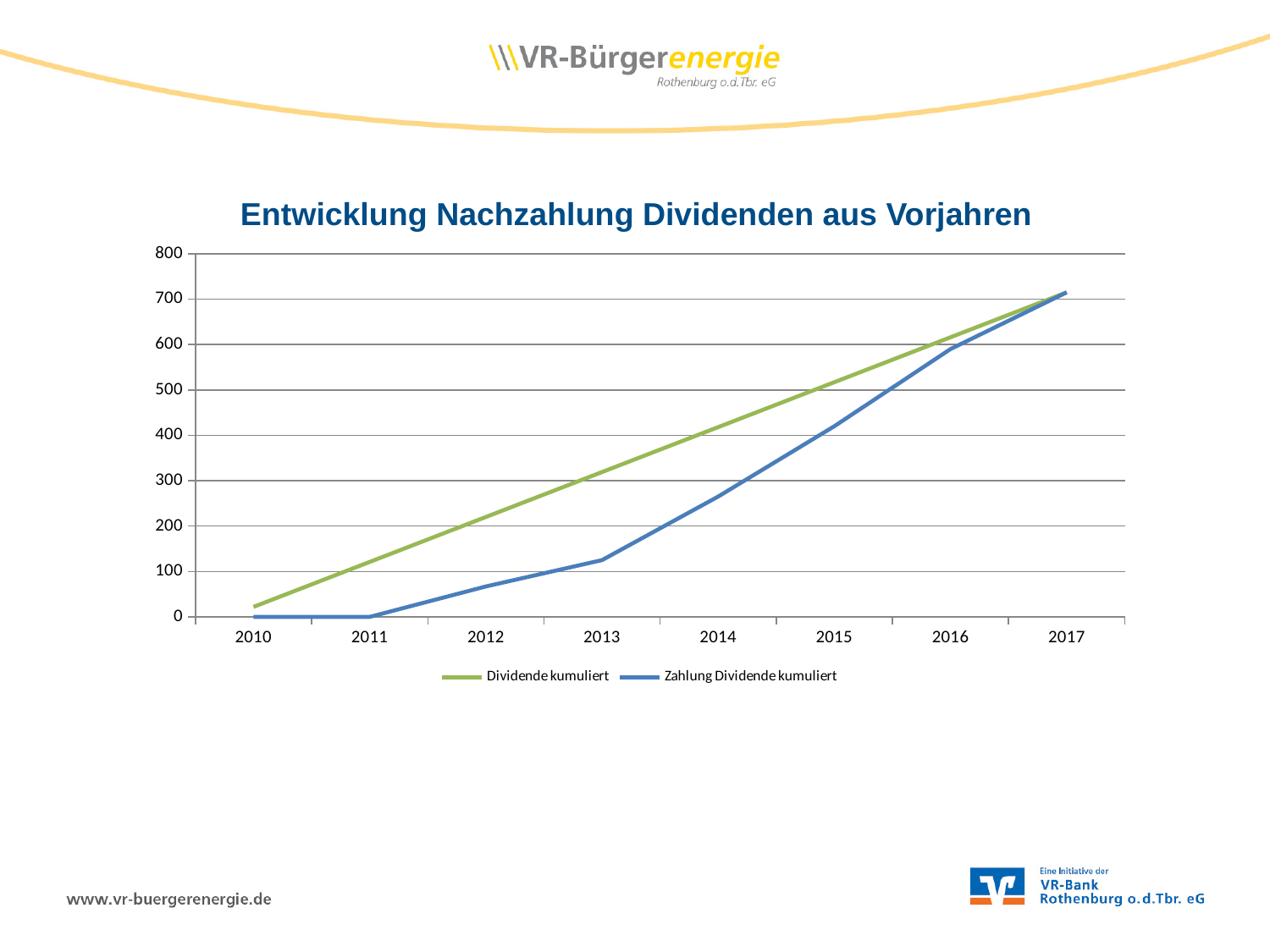
What is the title of the chart? Entwicklung Nachzahlung Dividenden aus Vorjahren What is the value of Zahlung Dividende kumuliert in 2011? 0 Is the value of Zahlung Dividende kumuliert in 2017 greater or less than 600? greater What is the value of Zahlung Dividende kumuliert in 2010? 0 Do the values of Dividende kumuliert rise or fall from 2010 to 2017? rise What kind of chart is shown on the slide? line chart In which year does Zahlung Dividende kumuliert reach its highest value? 2017 How many years are plotted along the x axis? 8 Is the value of Dividende kumuliert in 2015 greater or less than 400? greater In 2013, which series has the larger value, Dividende kumuliert or Zahlung Dividende kumuliert? Dividende kumuliert Is the value of Zahlung Dividende kumuliert in 2012 greater or less than 100? less How many series does the legend list? 2